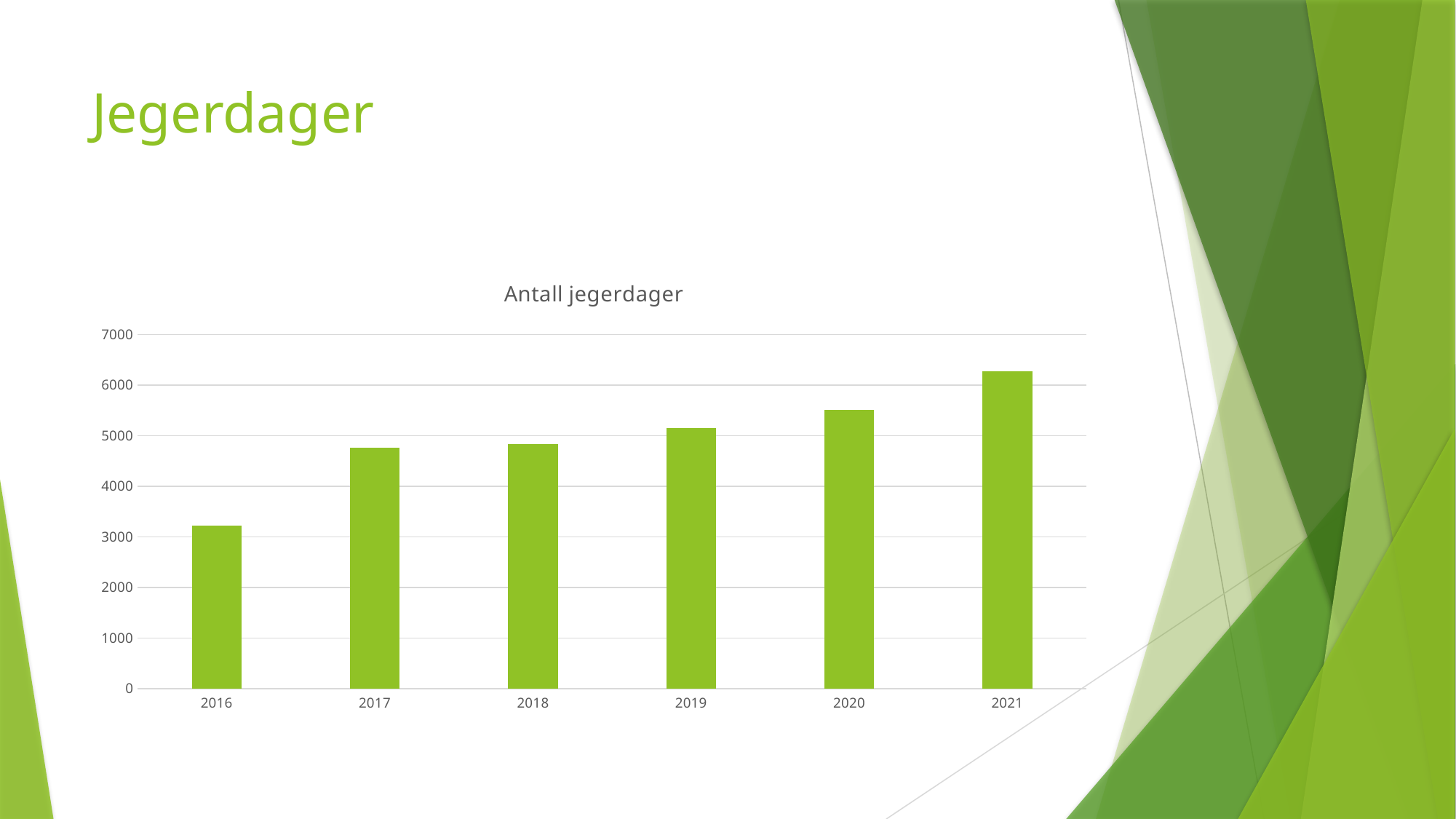
Is the value for 2021 greater or less than 6000? greater Which year has the lowest number of jegerdager? 2016 Which is larger, the value for 2020 or the value for 2017? 2020 Is the value for 2016 greater or less than 4000? less What is the title of the chart? Antall jegerdager What kind of chart is shown on the slide? bar chart How many years are shown on the x axis of the chart? 6 Is the value for 2020 greater or less than 5000? greater Which year has the highest number of jegerdager? 2021 Which is larger, the value for 2016 or the value for 2019? 2019 Do the values rise or fall from 2016 to 2021? rise